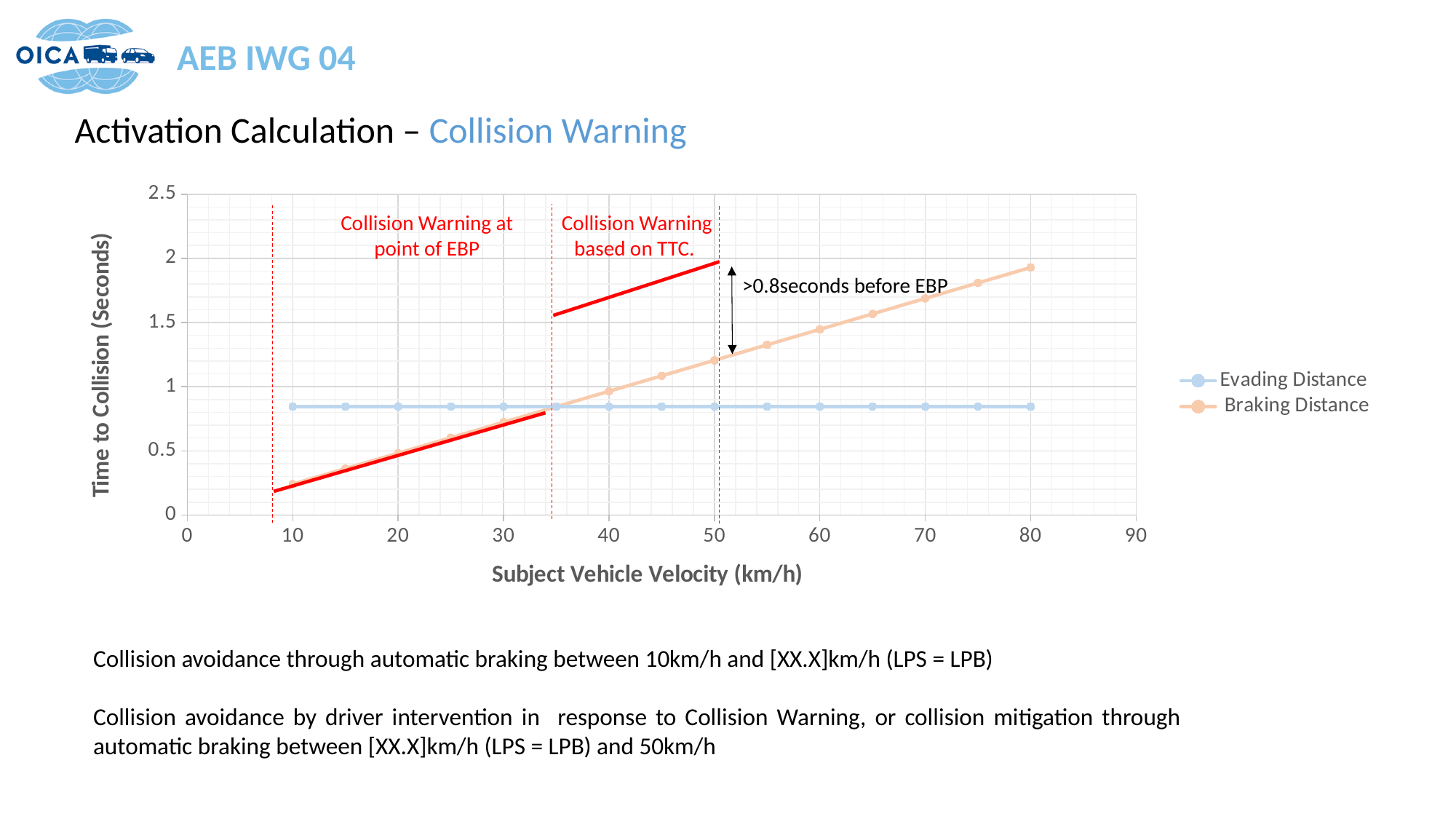
What type of chart is shown on the slide? line chart Is the Braking Distance value at 80 km/h greater or less than 1.5? greater Is the Evading Distance value at 40 km/h greater or less than 1? less How many series does the legend list? 2 What are the two series named in the legend? Evading Distance and Braking Distance At 80 km/h, which series has the larger value, Evading Distance or Braking Distance? Braking Distance Is the Braking Distance value at 10 km/h greater or less than 0.5? less At which Subject Vehicle Velocity does the Braking Distance series reach its highest value? 80 Does the Braking Distance series rise or fall as Subject Vehicle Velocity increases? rise At 10 km/h, which series has the larger value, Evading Distance or Braking Distance? Evading Distance What is the title of the x axis? Subject Vehicle Velocity (km/h)